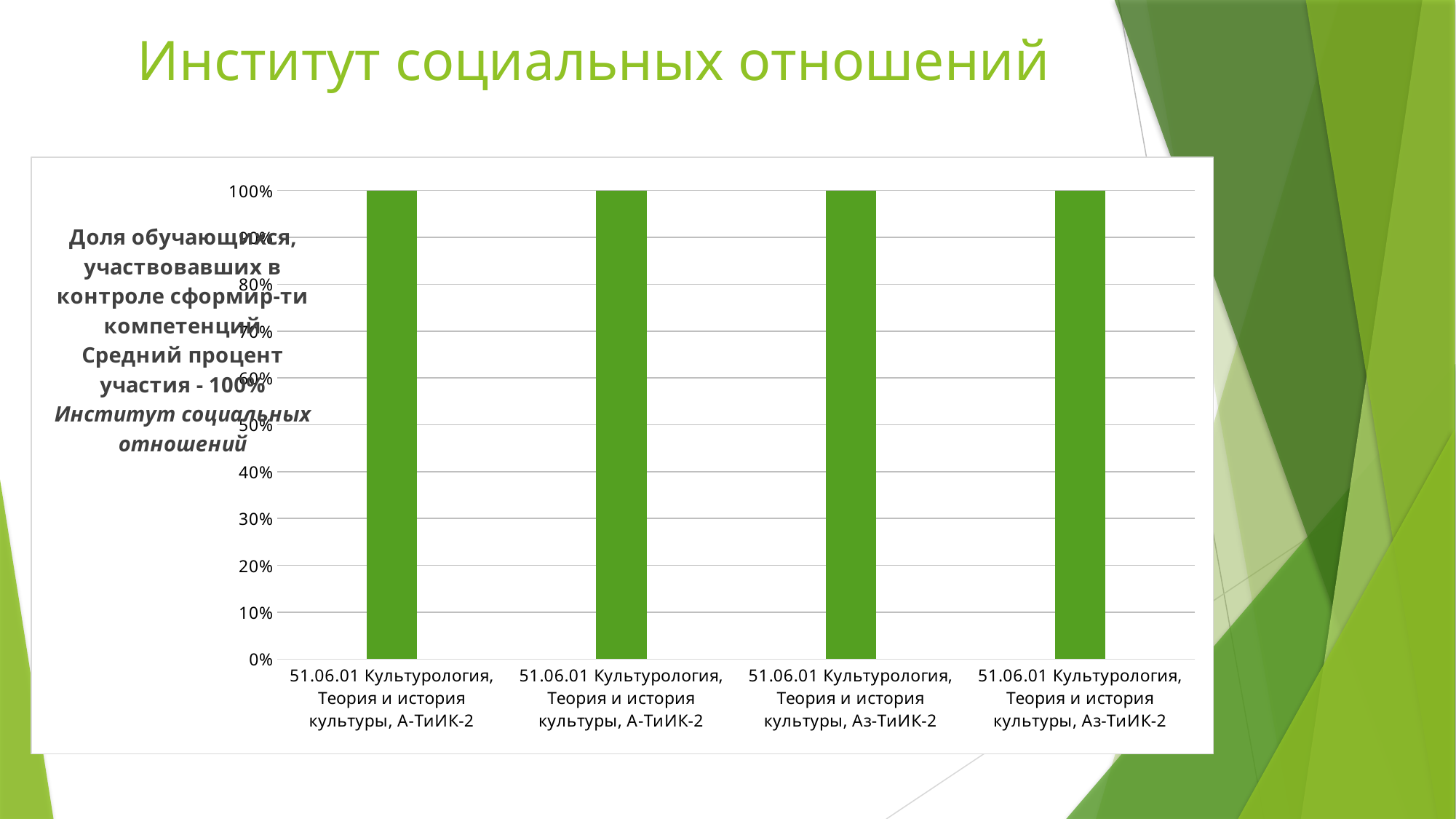
Do the bar values rise, fall, or stay the same from left to right across the chart? stay the same What kind of chart is shown on the slide? bar chart Is the value of the third bar greater or less than 50%? greater What colour are the bars in the chart? green Is the value of the second bar greater or less than 90%? greater What is the highest value shown on the vertical axis of the chart? 100% What is the value of the first (leftmost) bar, labelled 51.06.01 Культурология, Теория и история культуры, А-ТиИК-2? 100% How many bars are plotted in the chart? 4 What is the difference between the value of the first bar and the value of the fourth bar? 0% What average participation percentage (Средний процент участия) is stated in the chart title? 100% What is the value of the rightmost bar, labelled 51.06.01 Культурология, Теория и история культуры, Аз-ТиИК-2? 100%